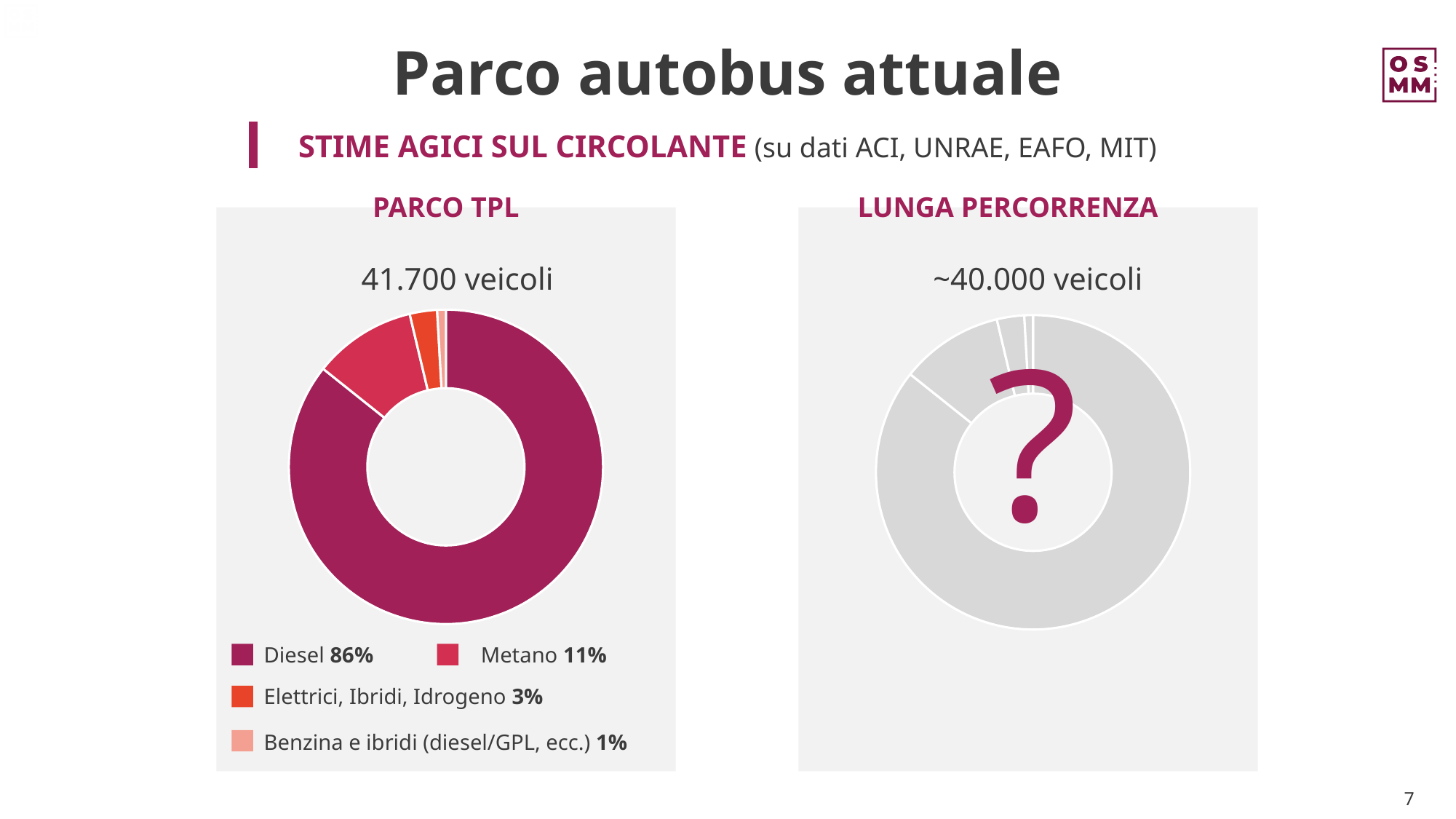
In the PARCO TPL chart, what share do Elettrici, Ibridi, Idrogeno have? 3% In the PARCO TPL chart, what share does Metano have? 11% In the PARCO TPL chart, which is larger: Metano or Elettrici, Ibridi, Idrogeno? Metano In the PARCO TPL chart, what share does Benzina e ibridi (diesel/GPL, ecc.) have? 1% How many vehicles does the PARCO TPL chart report in total? 41.700 veicoli In the PARCO TPL chart, what is the difference in percentage points between Diesel and Metano? 75 How many categories does the PARCO TPL chart's legend list? 4 In the PARCO TPL chart, which category has the largest share? Diesel In the PARCO TPL chart, what share does Diesel have? 86% What kind of chart is the PARCO TPL chart? Donut (pie) chart How many vehicles does the LUNGA PERCORRENZA chart report? ~40.000 veicoli In the PARCO TPL chart, which category has the smallest share? Benzina e ibridi (diesel/GPL, ecc.)